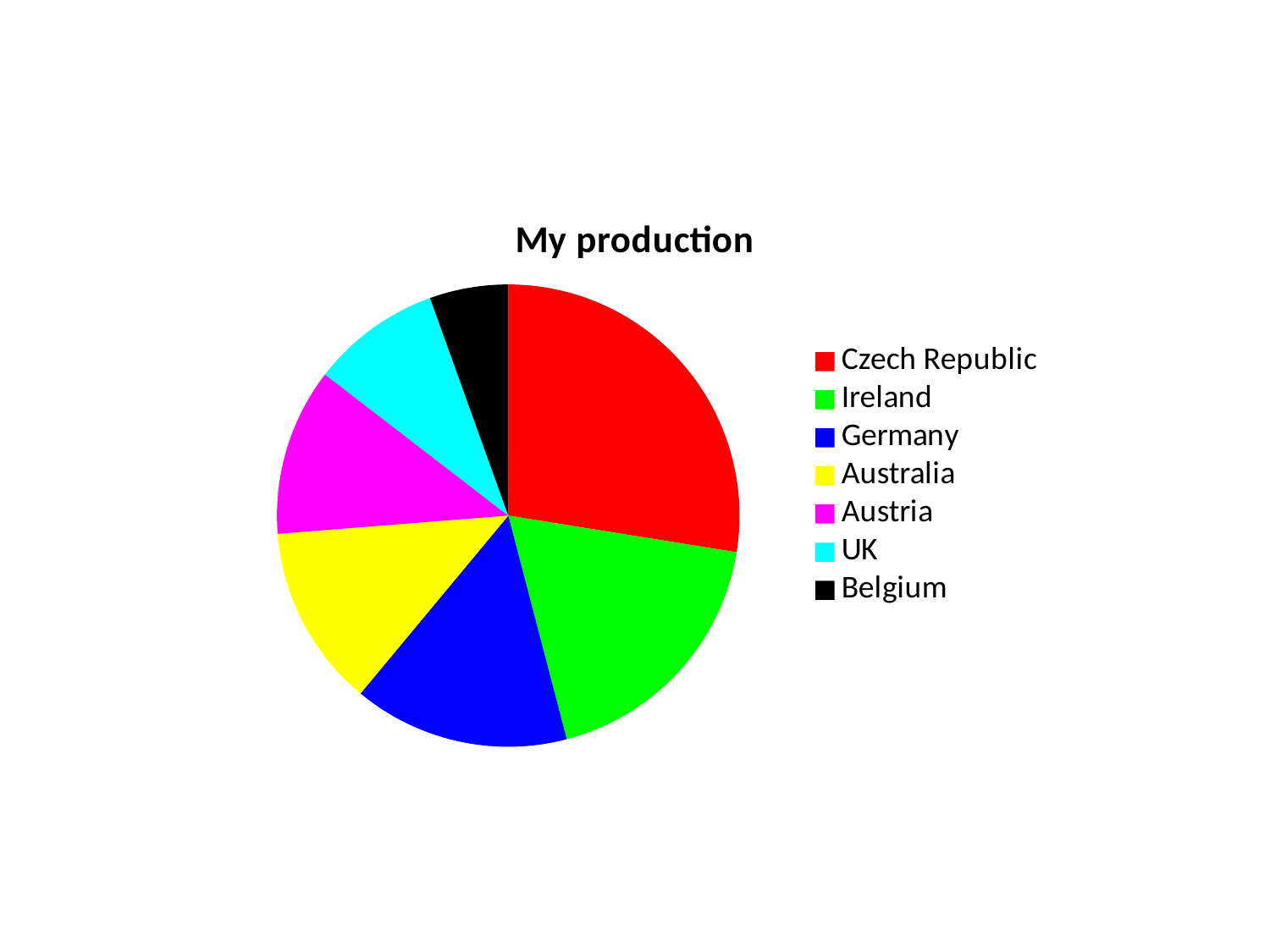
Which slice is larger, Austria or Belgium? Austria Which slice is larger, Ireland or UK? Ireland Which slice is larger, Czech Republic or Ireland? Czech Republic What is the title of the chart? My production Which category has the largest slice of the pie? Czech Republic What kind of chart is shown on the slide? Pie chart Which category has the smallest slice of the pie? Belgium Which colour represents Germany in the pie chart? Blue How many categories (slices) does the pie chart have? 7